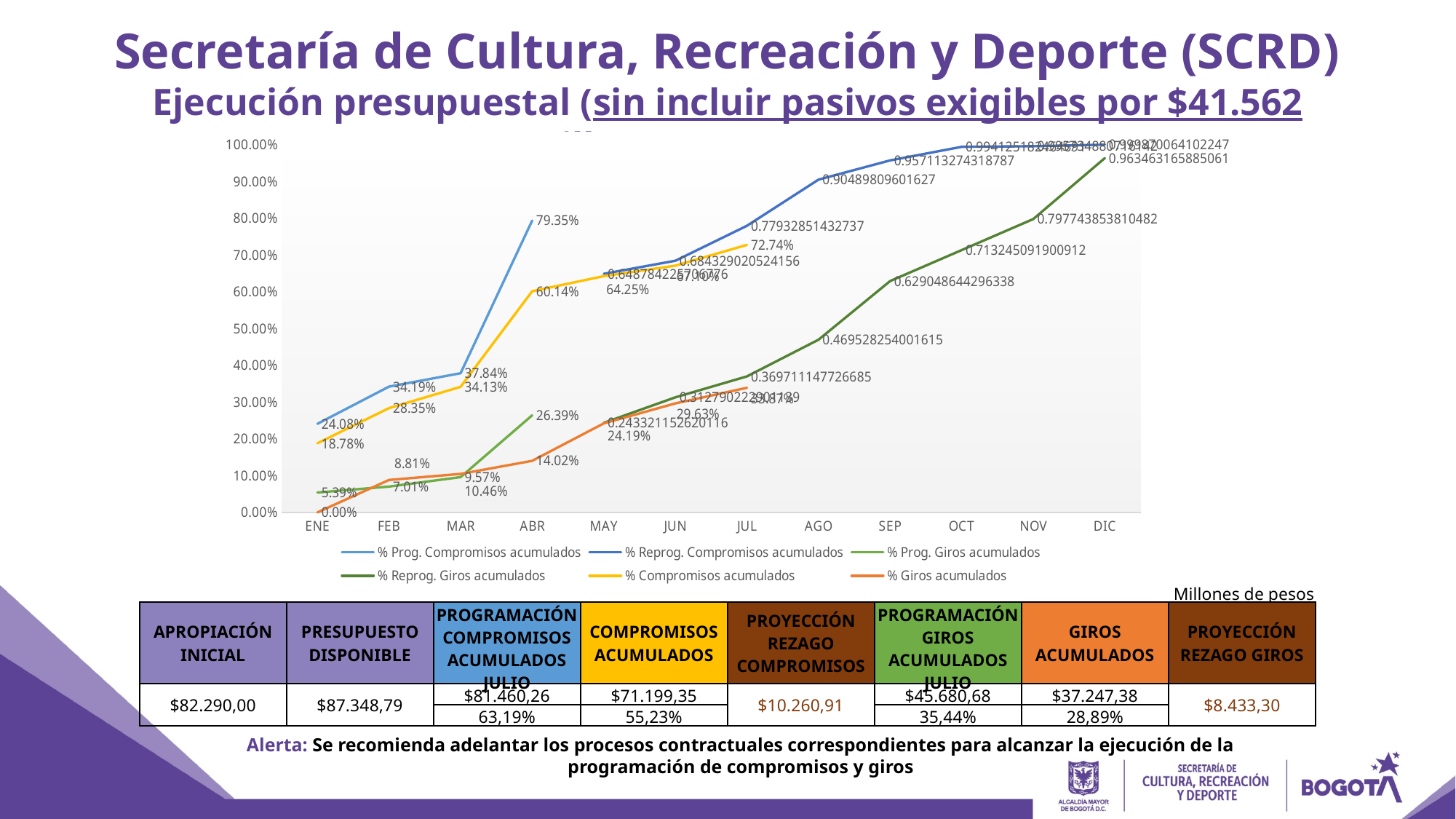
How many series does the chart legend list? 6 What is the value of % Prog. Giros acumulados in ABR? 26.39% Is the value for % Reprog. Giros acumulados in SEP greater or less than 60%? greater What is the value of % Prog. Compromisos acumulados in ABR? 79.35% What is the value of % Compromisos acumulados in JUL? 72.74% How many months are shown along the x axis of the chart? 12 In which month does the % Prog. Compromisos acumulados line reach its highest value? ABR In ENE, which is larger: % Prog. Compromisos acumulados or % Compromisos acumulados? % Prog. Compromisos acumulados What is the data label for % Reprog. Giros acumulados in DIC? 0.963463165885061 What is the difference between % Prog. Compromisos acumulados and % Compromisos acumulados in ABR? 19.21 percentage points What kind of chart is shown on the slide? line chart What is the value of % Giros acumulados in ENE? 0.00%